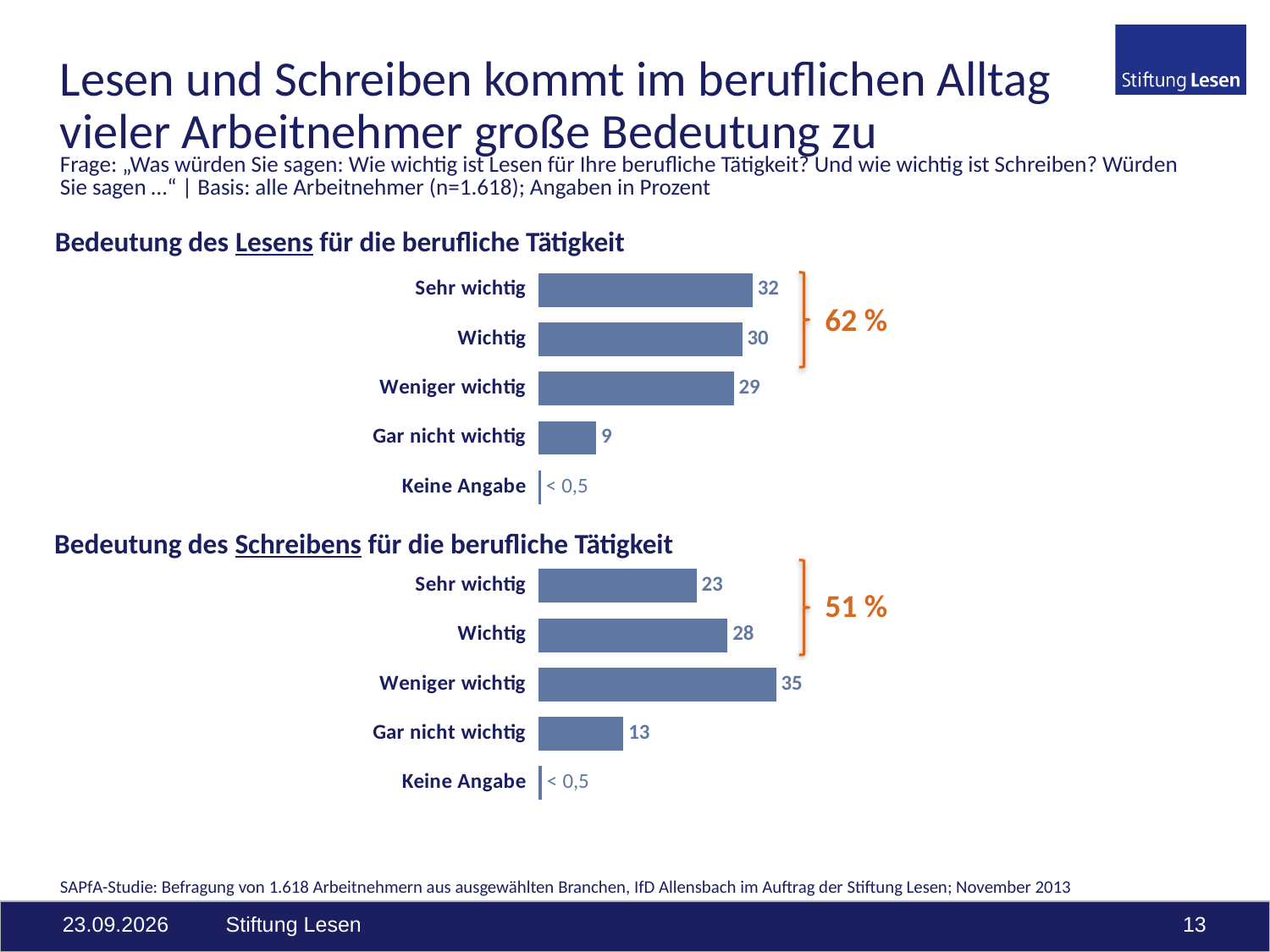
What kind of chart is 'Bedeutung des Schreibens für die berufliche Tätigkeit'? Bar chart In the chart 'Bedeutung des Lesens für die berufliche Tätigkeit', what is the difference between 'Wichtig' and 'Gar nicht wichtig'? 21 In the chart 'Bedeutung des Lesens für die berufliche Tätigkeit', which category has the highest value? Sehr wichtig In the chart 'Bedeutung des Schreibens für die berufliche Tätigkeit', which category has the highest value? Weniger wichtig Which is larger: 'Sehr wichtig' in the Lesen chart or 'Sehr wichtig' in the Schreiben chart? Lesen chart In the chart 'Bedeutung des Schreibens für die berufliche Tätigkeit', what is the value for 'Sehr wichtig'? 23 In the chart 'Bedeutung des Schreibens für die berufliche Tätigkeit', what is the value for 'Weniger wichtig'? 35 What combined percentage is shown by the bracket for 'Sehr wichtig' and 'Wichtig' in the Schreiben chart? 51 % How many categories does the chart 'Bedeutung des Lesens für die berufliche Tätigkeit' show? 5 In the chart 'Bedeutung des Lesens für die berufliche Tätigkeit', what is the value for 'Sehr wichtig'? 32 In the chart 'Bedeutung des Lesens für die berufliche Tätigkeit', what is the value for 'Gar nicht wichtig'? 9 In the chart 'Bedeutung des Schreibens für die berufliche Tätigkeit', what is the difference between 'Weniger wichtig' and 'Gar nicht wichtig'? 22